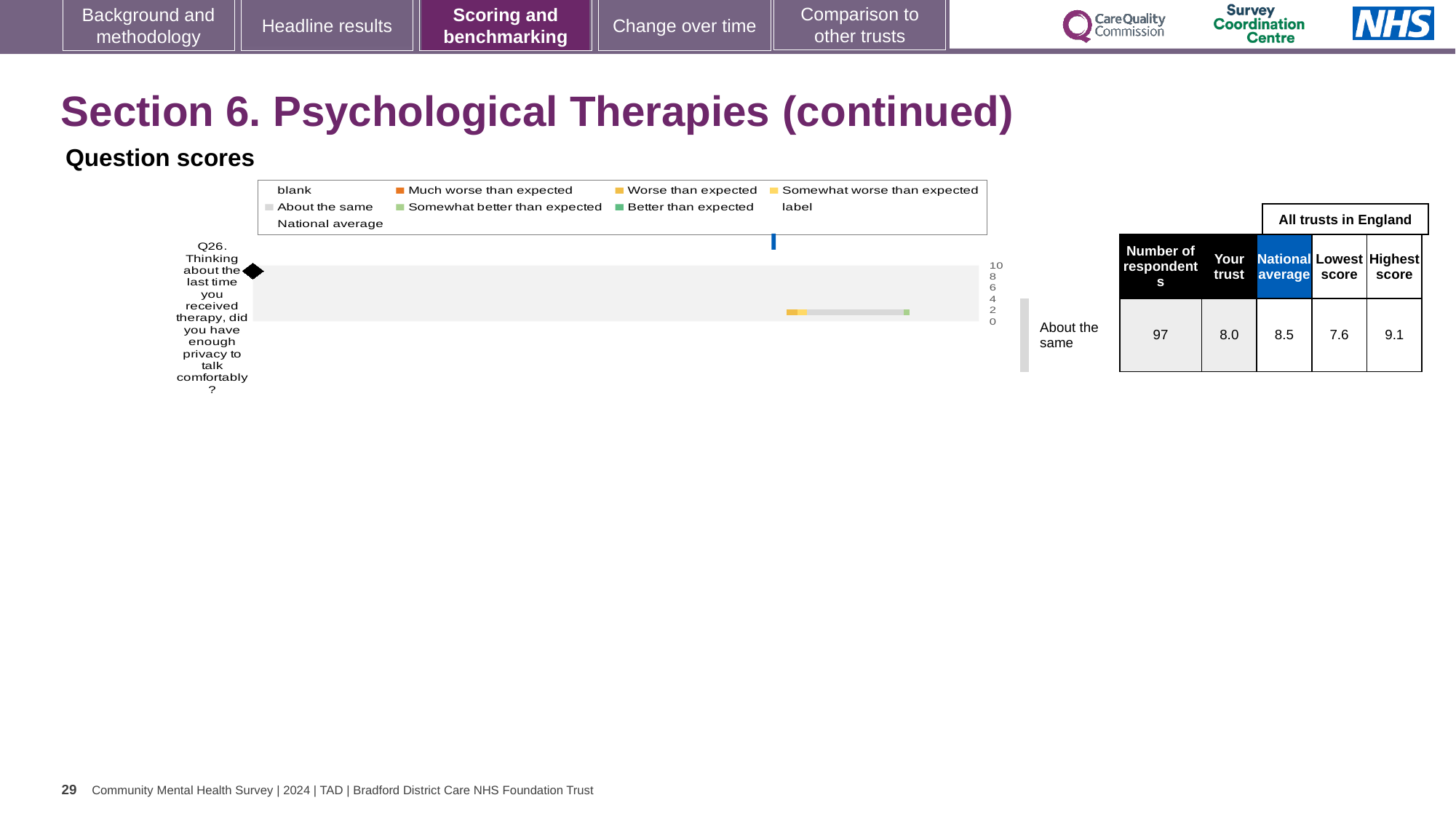
What is the highest score among all trusts in England for Q26? 9.1 Which legend entry is shown in orange in the question scores chart? Much worse than expected Which is larger for Q26, the trust's score or the national average? National average How many questions are plotted in the question scores chart on this slide? 1 What is the difference between the national average and the trust's score for Q26? 0.5 How is the trust's Q26 result categorised relative to expectations? About the same How many respondents answered Q26? 97 What is the 'Your trust' score for Q26 about having enough privacy to talk comfortably during therapy? 8.0 What is the maximum value shown on the chart's score axis? 10 What is the difference between the highest score and the lowest score for Q26 across all trusts in England? 1.5 What is the lowest score among all trusts in England for Q26? 7.6 What is the national average score for Q26 shown on the slide? 8.5